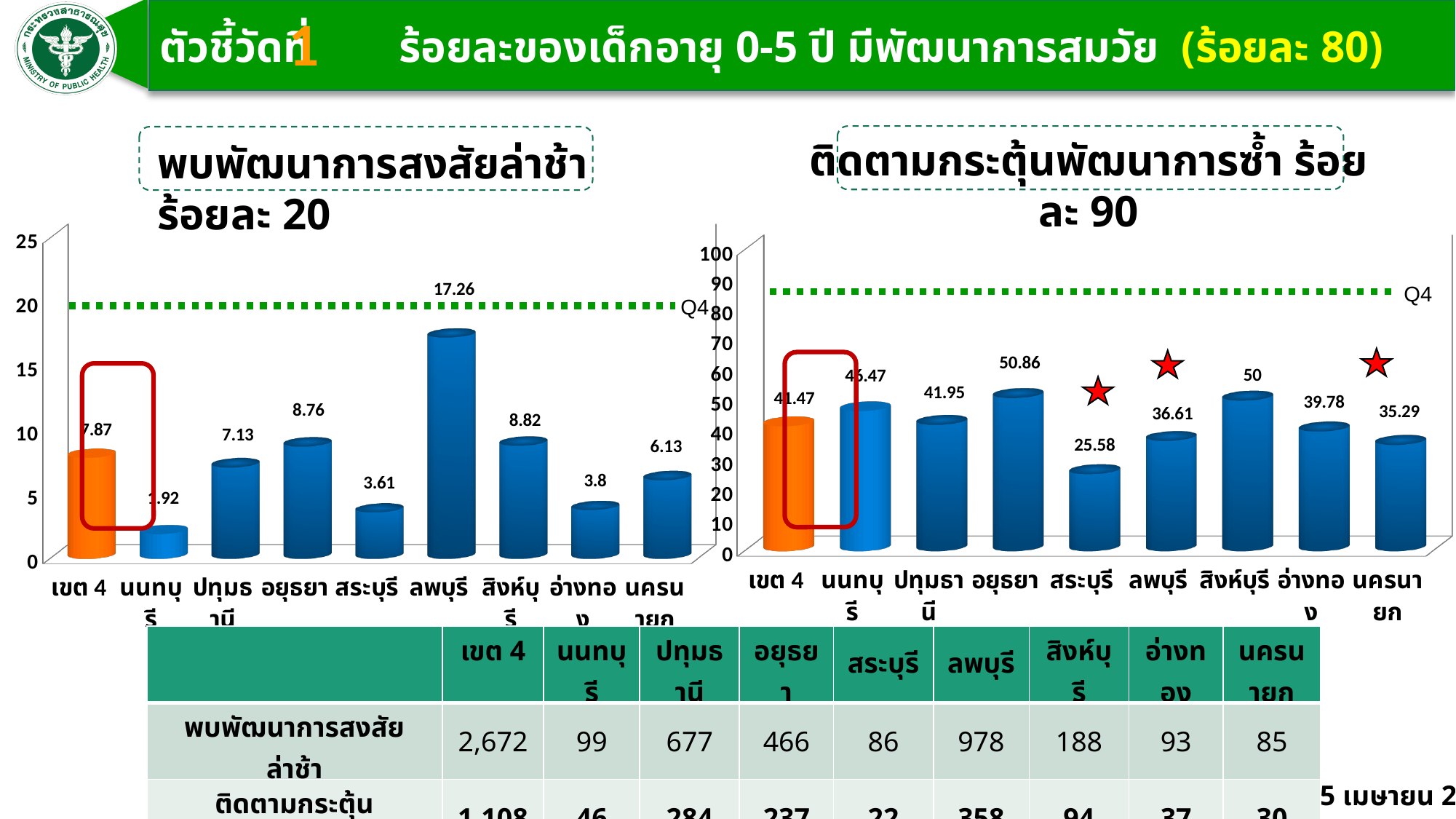
In the right chart (ติดตามกระตุ้นพัฒนาการซ้ำ), what is the value for อยุธยา? 50.86 In the left chart (พบพัฒนาการสงสัยล่าช้า), which category has the highest value? ลพบุรี In the left chart (พบพัฒนาการสงสัยล่าช้า), what is the value for ลพบุรี? 17.26 In the right chart (ติดตามกระตุ้นพัฒนาการซ้ำ), which category has the lowest value? สระบุรี In the left chart (พบพัฒนาการสงสัยล่าช้า), how many categories are shown on the x axis? 9 In the left chart (พบพัฒนาการสงสัยล่าช้า), what is the difference between สิงห์บุรี and อ่างทอง? 5.02 In the left chart (พบพัฒนาการสงสัยล่าช้า), what is the value for อยุธยา? 8.76 In the right chart (ติดตามกระตุ้นพัฒนาการซ้ำ), which is larger, ลพบุรี or อ่างทอง? อ่างทอง What kind of chart is the right chart (ติดตามกระตุ้นพัฒนาการซ้ำ)? Bar chart In the right chart (ติดตามกระตุ้นพัฒนาการซ้ำ), what label is shown next to the green dotted line? Q4 In the left chart (พบพัฒนาการสงสัยล่าช้า), which category has the lowest value? นนทบุรี In the right chart (ติดตามกระตุ้นพัฒนาการซ้ำ), what is the difference between สิงห์บุรี and นครนายก? 14.71